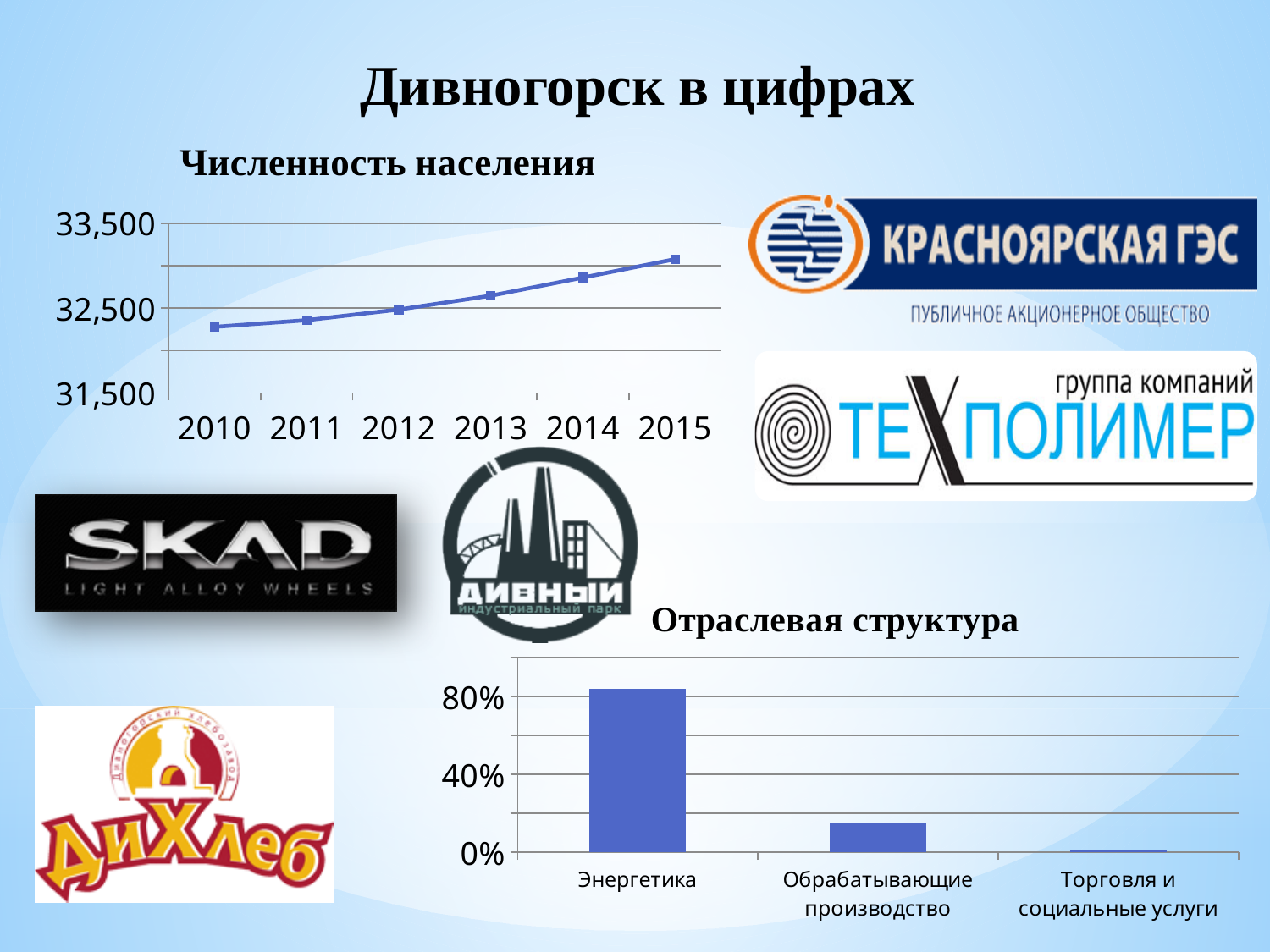
On the "Численность населения" chart, is the value for 2015 greater or less than 32,500? greater On the "Численность населения" chart, which year has the lowest value? 2010 On the "Отраслевая структура" chart, which category has the highest value? Энергетика On the "Отраслевая структура" chart, which is larger: Обрабатывающие производство or Торговля и социальные услуги? Обрабатывающие производство On the "Отраслевая структура" chart, is the value for Энергетика greater or less than 80%? greater What kind of chart is the "Отраслевая структура" chart? bar chart On the "Численность населения" chart, is the value for 2010 greater or less than 32,500? less On the "Численность населения" chart, which year has the highest value? 2015 How many categories are shown on the "Отраслевая структура" chart? 3 Do the values on the "Численность населения" chart rise or fall from 2010 to 2015? rise What kind of chart is the "Численность населения" chart? line chart How many years are plotted on the "Численность населения" chart? 6